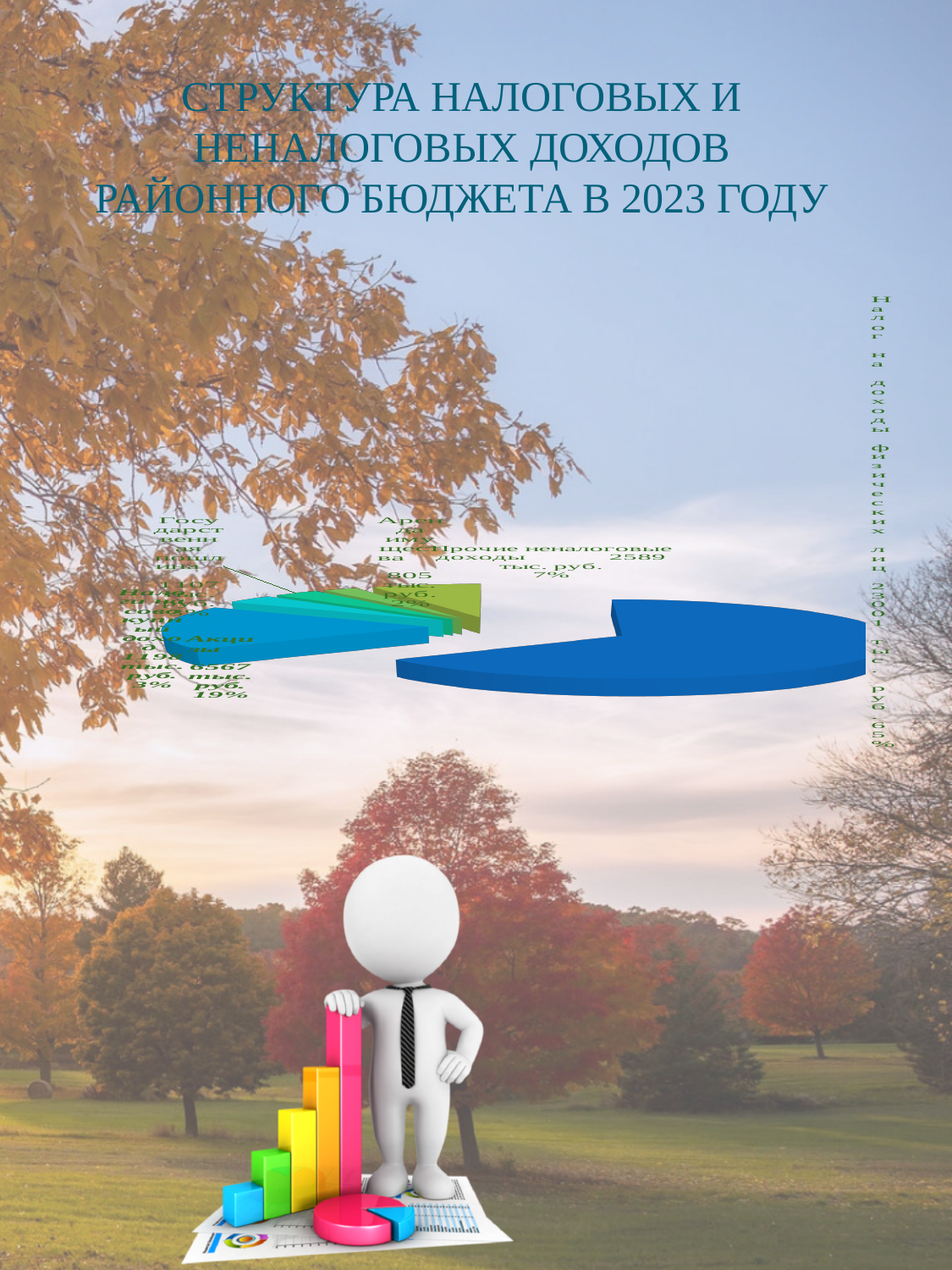
What is the value shown for Налог на доходы физических лиц? 23001 тыс. руб. What is the value shown for Прочие неналоговые доходы? 2589 тыс. руб. What is the value shown for Аренда имущества? 805 тыс. руб. Which category has the largest slice of the pie? Налог на доходы физических лиц What share of the pie does Акцизы represent? 19% What share of the pie does Налог на доходы физических лиц represent? 65% What kind of chart is shown on the slide? pie chart What colour is the largest slice of the pie? blue What share of the pie does Прочие неналоговые доходы represent? 7% What is the difference between the value for Налог на доходы физических лиц and the value for Акцизы? 16434 тыс. руб. What is the title of the slide? СТРУКТУРА НАЛОГОВЫХ И НЕНАЛОГОВЫХ ДОХОДОВ РАЙОННОГО БЮДЖЕТА В 2023 ГОДУ Which is larger, the value for Акцизы or the value for Прочие неналоговые доходы? Акцизы